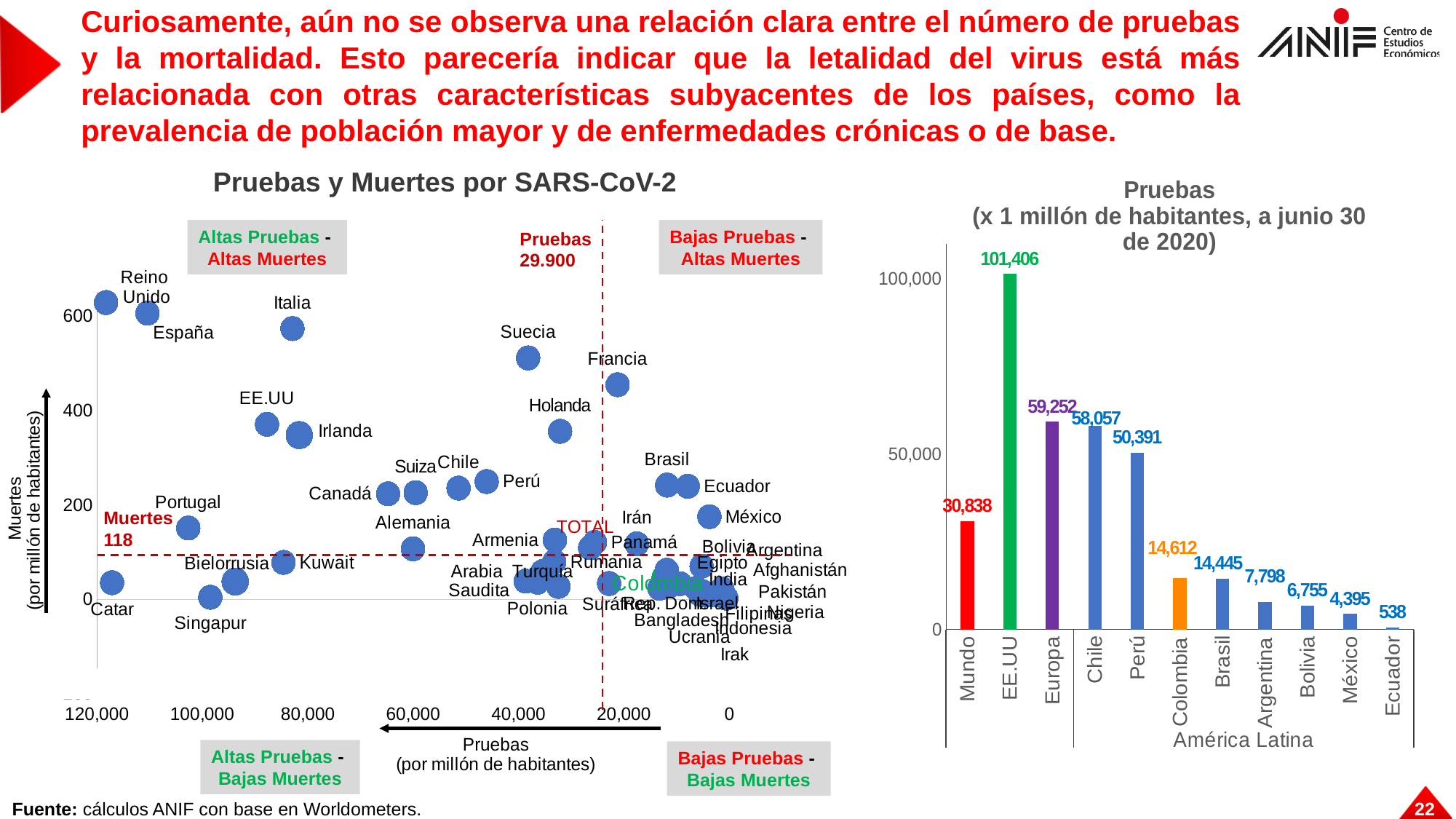
In the chart titled 'Pruebas (x 1 millón de habitantes, a junio 30 de 2020)', what is the value for Colombia? 14,612 In the chart titled 'Pruebas (x 1 millón de habitantes, a junio 30 de 2020)', which is larger, the value for Europa or the value for Chile? Europa What kind of chart is the chart titled 'Pruebas y Muertes por SARS-CoV-2'? scatter chart In the chart titled 'Pruebas (x 1 millón de habitantes, a junio 30 de 2020)', what is the difference between the values for Chile and Perú? 7,666 In the chart titled 'Pruebas (x 1 millón de habitantes, a junio 30 de 2020)', which category has the highest value? EE.UU In the chart titled 'Pruebas (x 1 millón de habitantes, a junio 30 de 2020)', which category has the lowest value? Ecuador In the chart titled 'Pruebas y Muertes por SARS-CoV-2', is the Muertes value for Holanda greater or less than 400? less In the chart titled 'Pruebas (x 1 millón de habitantes, a junio 30 de 2020)', how many categories are shown on the x axis? 11 In the chart titled 'Pruebas y Muertes por SARS-CoV-2', what Muertes value is marked by the horizontal dashed reference line? 118 In the chart titled 'Pruebas (x 1 millón de habitantes, a junio 30 de 2020)', what is the value for EE.UU? 101,406 In the chart titled 'Pruebas (x 1 millón de habitantes, a junio 30 de 2020)', what is the difference between the values for Mundo and Colombia? 16,226 What kind of chart is the chart titled 'Pruebas (x 1 millón de habitantes, a junio 30 de 2020)'? bar chart